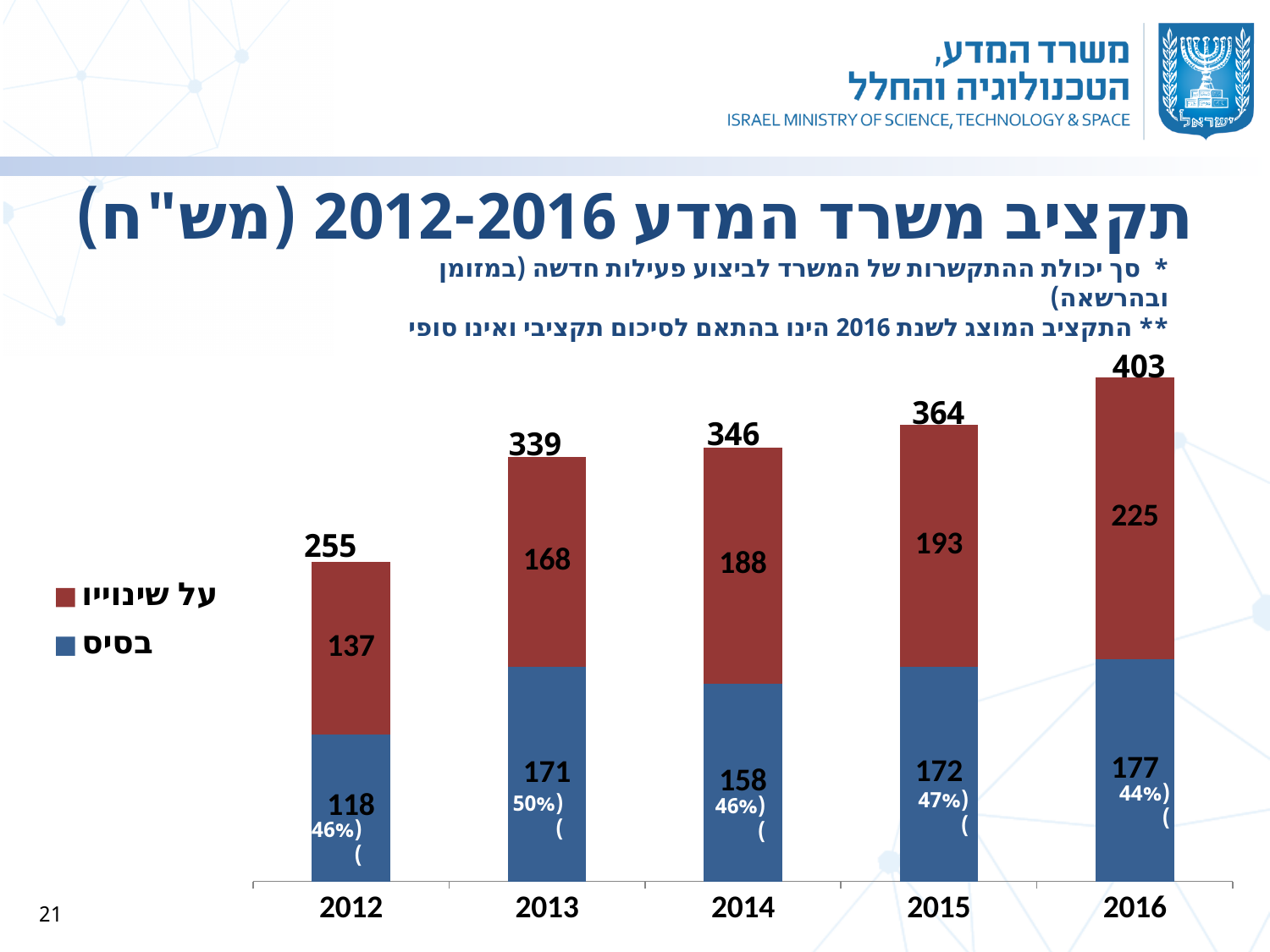
What is the difference between the total budget for 2016 and the total budget for 2012? 148 Which is larger for 2015: the בסיס value or the על שינוייו value? על שינוייו (193) How many years are shown on the x axis? 5 What type of chart is shown on the slide? Stacked bar chart What percentage share is printed for the בסיס series in 2016? 44% Which year has the lowest total budget? 2012 Which year has the highest total budget? 2016 What is the total budget shown for 2016? 403 How many series does the legend list? 2 Do the total budget values rise or fall from 2012 to 2016? Rise What is the value of the בסיס (base) series for 2013? 171 What is the value of the על שינוייו series for 2014? 188